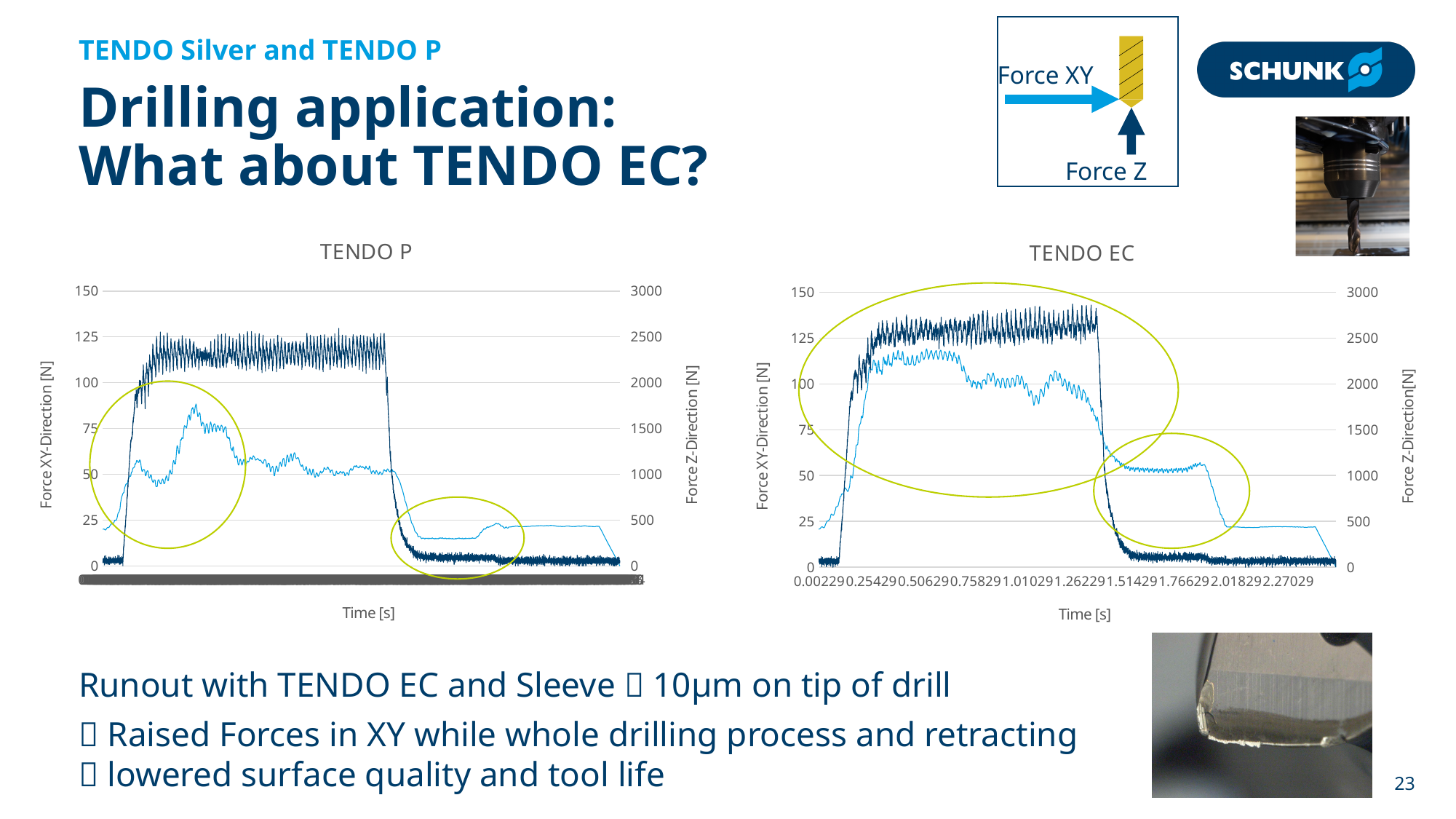
In the TENDO EC chart, what is the first tick label on the x axis? 0.00229 In the TENDO P chart, what is the maximum value shown on the left vertical axis? 150 In the TENDO EC chart, how many tick labels are printed on the x axis? 10 In the TENDO EC chart, does the dark blue line rise or fall at around 1.5 s on the x axis? fall In the TENDO EC chart, does the light blue line's plateau during drilling lie above or below the 75 gridline of the left axis? above Which chart shows the light blue line reaching higher values during the drilling plateau, TENDO P or TENDO EC? TENDO EC In the TENDO P chart, does the light blue line's plateau after about the middle of the drilling phase lie above or below the 75 gridline of the left axis? below What kind of chart is the TENDO P chart? line chart How many charts are shown on the slide? 2 What are the titles of the two charts on the slide? TENDO P and TENDO EC In the TENDO P chart, what is the maximum value shown on the right vertical axis? 3000 In the TENDO EC chart, what is the label of the left vertical axis? Force XY-Direction [N]